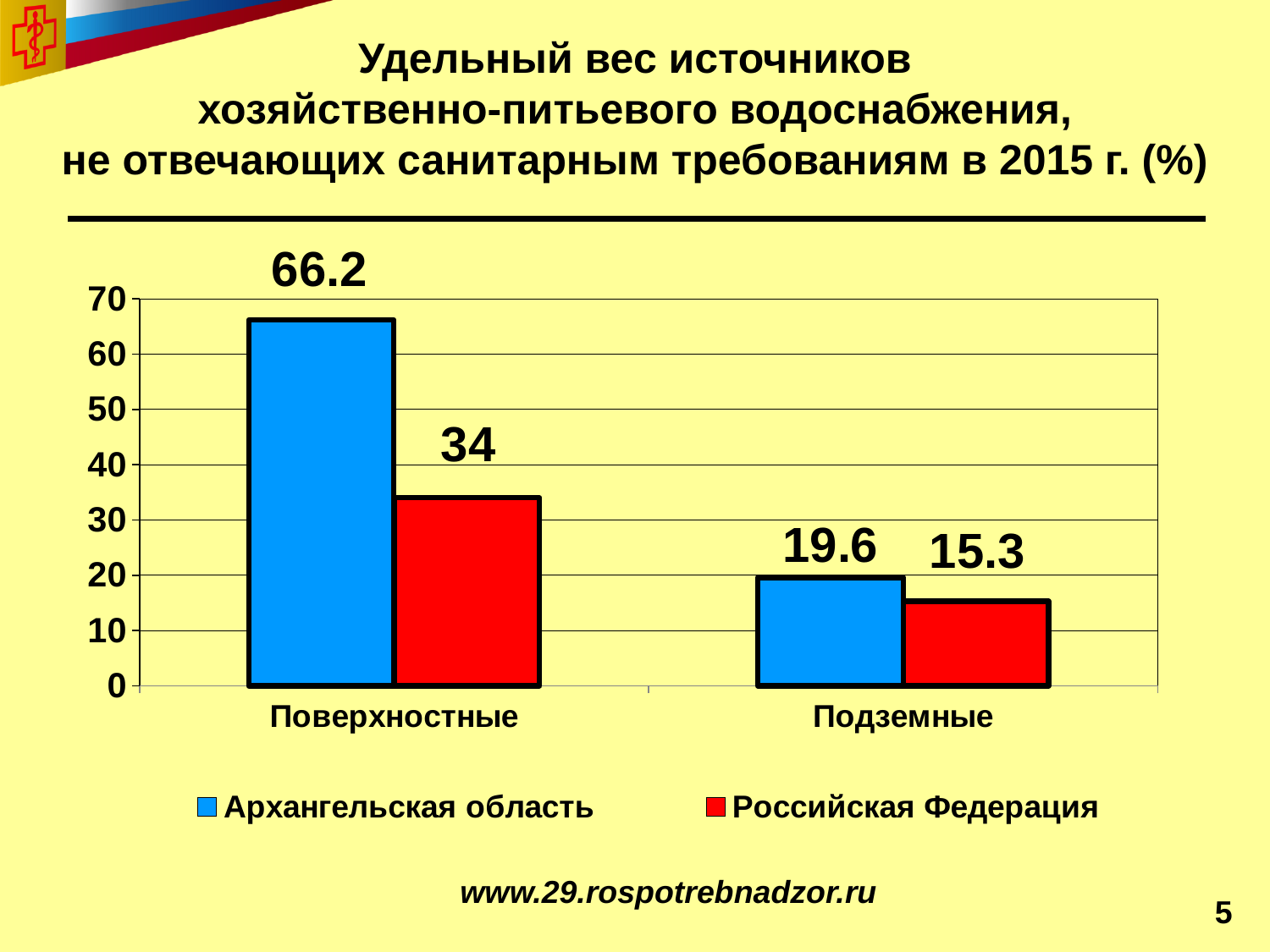
In the Подземные category, which series has the larger value: Архангельская область or Российская Федерация? Архангельская область What is the value for Российская Федерация in the Подземные category? 15.3 What is the difference between the Архангельская область and Российская Федерация values in the Поверхностные category? 32.2 What is the difference between the Архангельская область and Российская Федерация values in the Подземные category? 4.3 Which category has the lowest value for Российская Федерация? Подземные What is the value for Архангельская область in the Подземные category? 19.6 How many series does the legend list? 2 Which category has the highest value for Архангельская область? Поверхностные How many categories are shown on the x axis? 2 What is the value for Архангельская область in the Поверхностные category? 66.2 What is the value for Российская Федерация in the Поверхностные category? 34 What kind of chart is shown on the slide? Bar chart